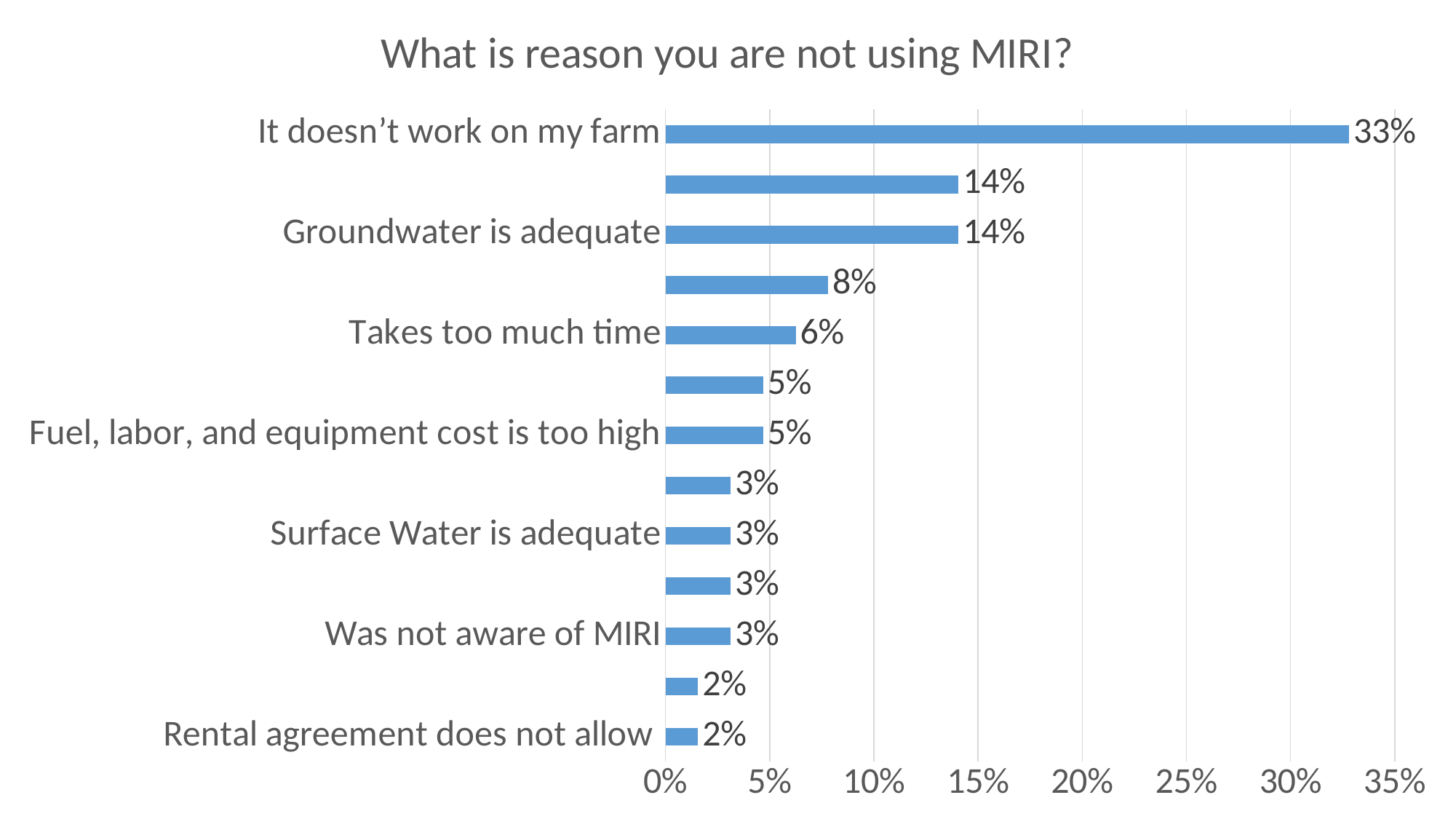
What is the title of the chart? What is reason you are not using MIRI? Which reason has the highest value? It doesn't work on my farm What is the difference between "It doesn't work on my farm" and "Groundwater is adequate"? 19% What is the value for "Groundwater is adequate"? 14% What is the value for "It doesn't work on my farm"? 33% Is the value for "It doesn't work on my farm" greater or less than 30%? greater What is the value for "Fuel, labor, and equipment cost is too high"? 5% How many bars are plotted in the chart? 13 Which is larger: "Groundwater is adequate" or "Takes too much time"? Groundwater is adequate What is the value for "Takes too much time"? 6% What is the value for "Rental agreement does not allow"? 2% What is the value for "Was not aware of MIRI"? 3%